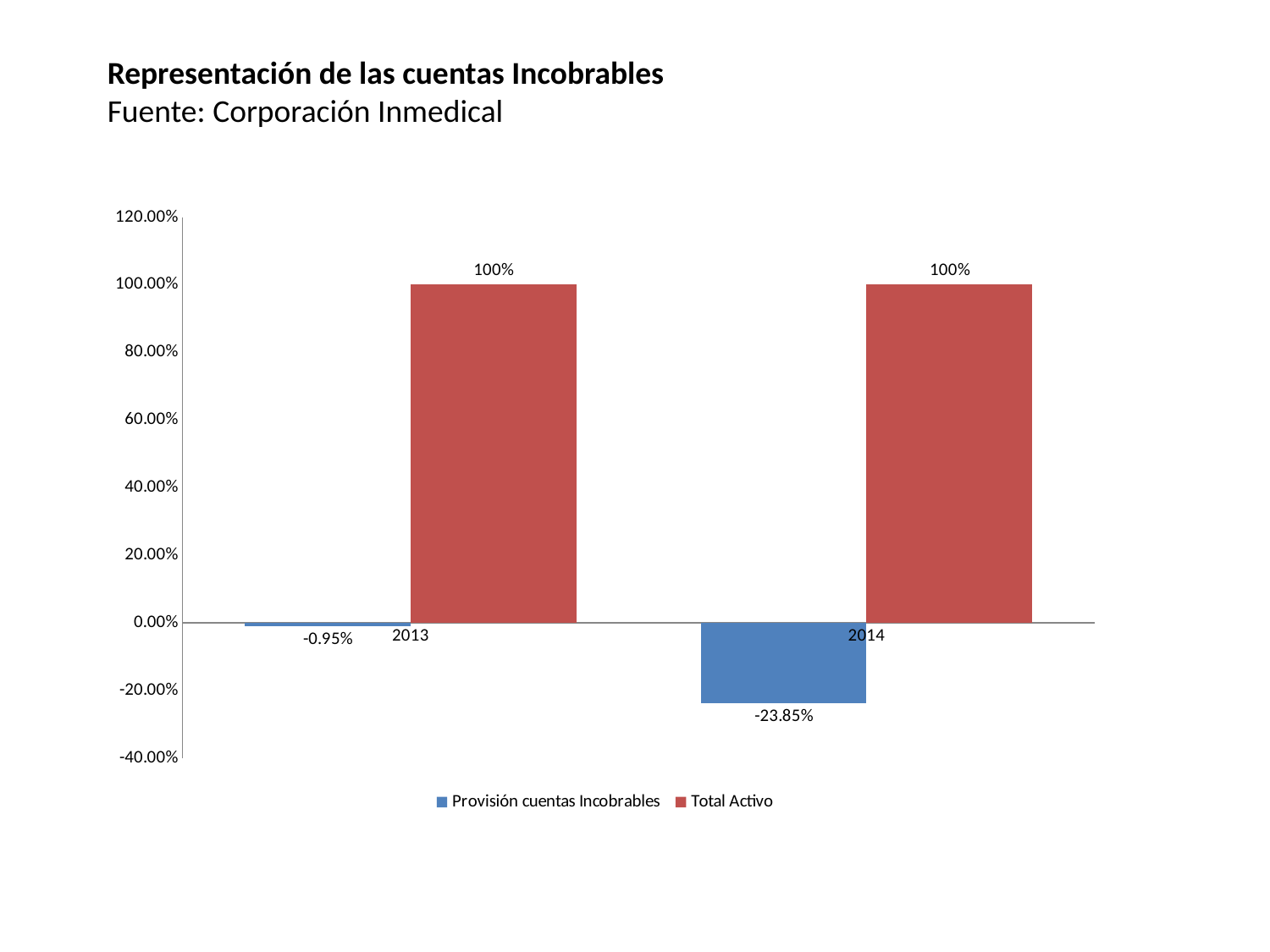
How many years are shown on the x axis? 2 How many series does the legend list? 2 Does the value of Provisión cuentas Incobrables rise or fall from 2013 to 2014? Fall What is the title of the chart? Representación de las cuentas Incobrables Is the value of Provisión cuentas Incobrables for 2014 greater or less than -20.00%? less What is the value of Provisión cuentas Incobrables for 2014? -23.85% What is the value of Provisión cuentas Incobrables for 2013? -0.95% Which is larger, Provisión cuentas Incobrables for 2013 or for 2014? 2013 What kind of chart is shown on the slide? Bar chart Which year has the lowest value for Provisión cuentas Incobrables? 2014 What is the value of Total Activo for 2014? 100% Which colour represents Total Activo in the legend? Red